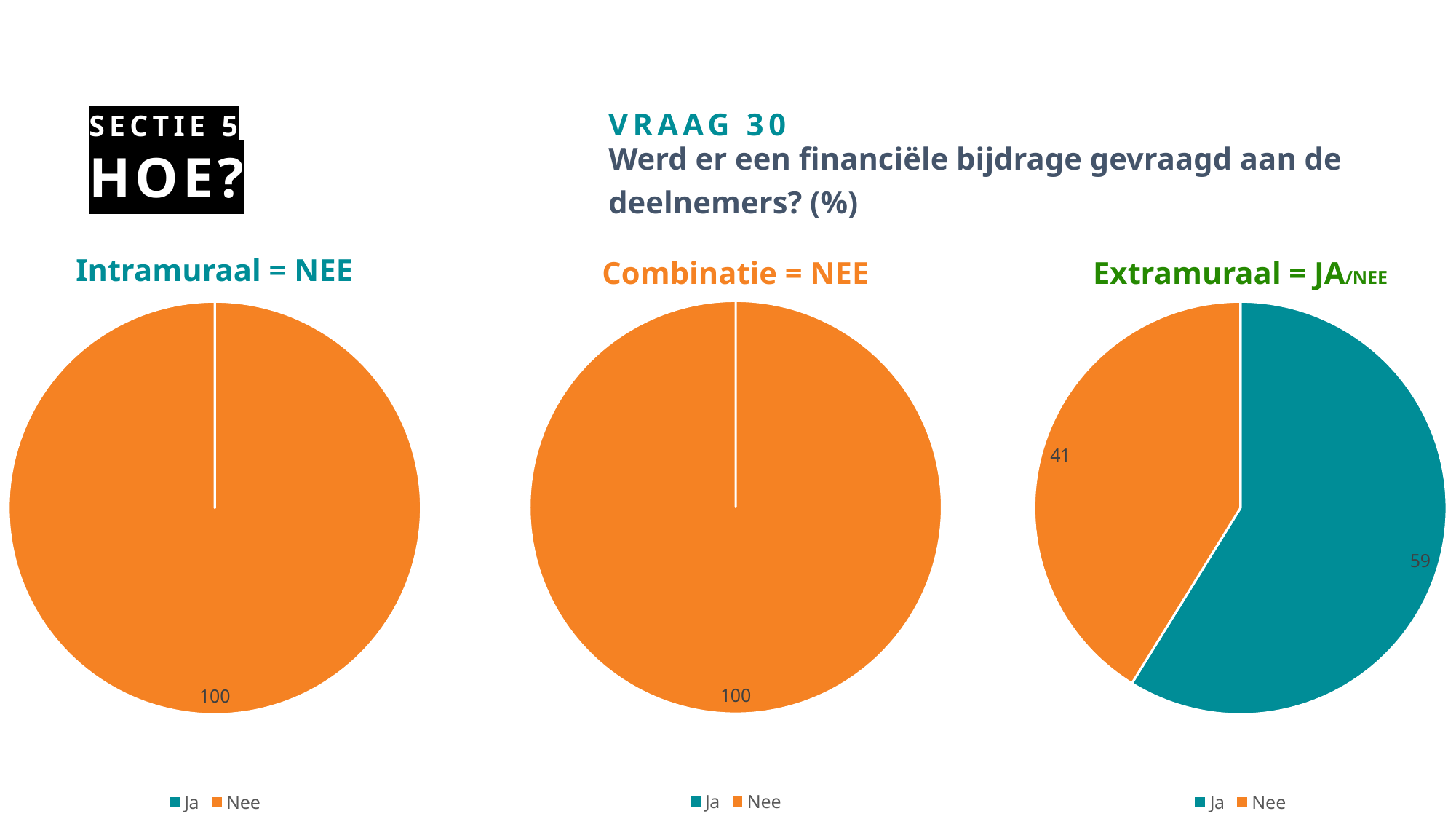
How many pie charts are shown on the slide? 3 In the Extramuraal pie chart, what is the value for Nee? 41 In the Combinatie pie chart, what is the value for Nee? 100 In the Extramuraal pie chart, what is the difference between the Ja and Nee values? 18 How many entries does the legend of the Combinatie chart list? 2 What is the title of the pie chart on the left of the slide? Intramuraal = NEE In the Extramuraal pie chart, what colour is the Ja slice? Teal What kind of chart is used for Intramuraal? Pie chart In the Intramuraal pie chart, what is the value for Nee? 100 In the Extramuraal pie chart, what is the value for Ja? 59 In the Extramuraal pie chart, which slice is larger, Ja or Nee? Ja In the Extramuraal pie chart, is the value for Ja greater or less than 50? greater